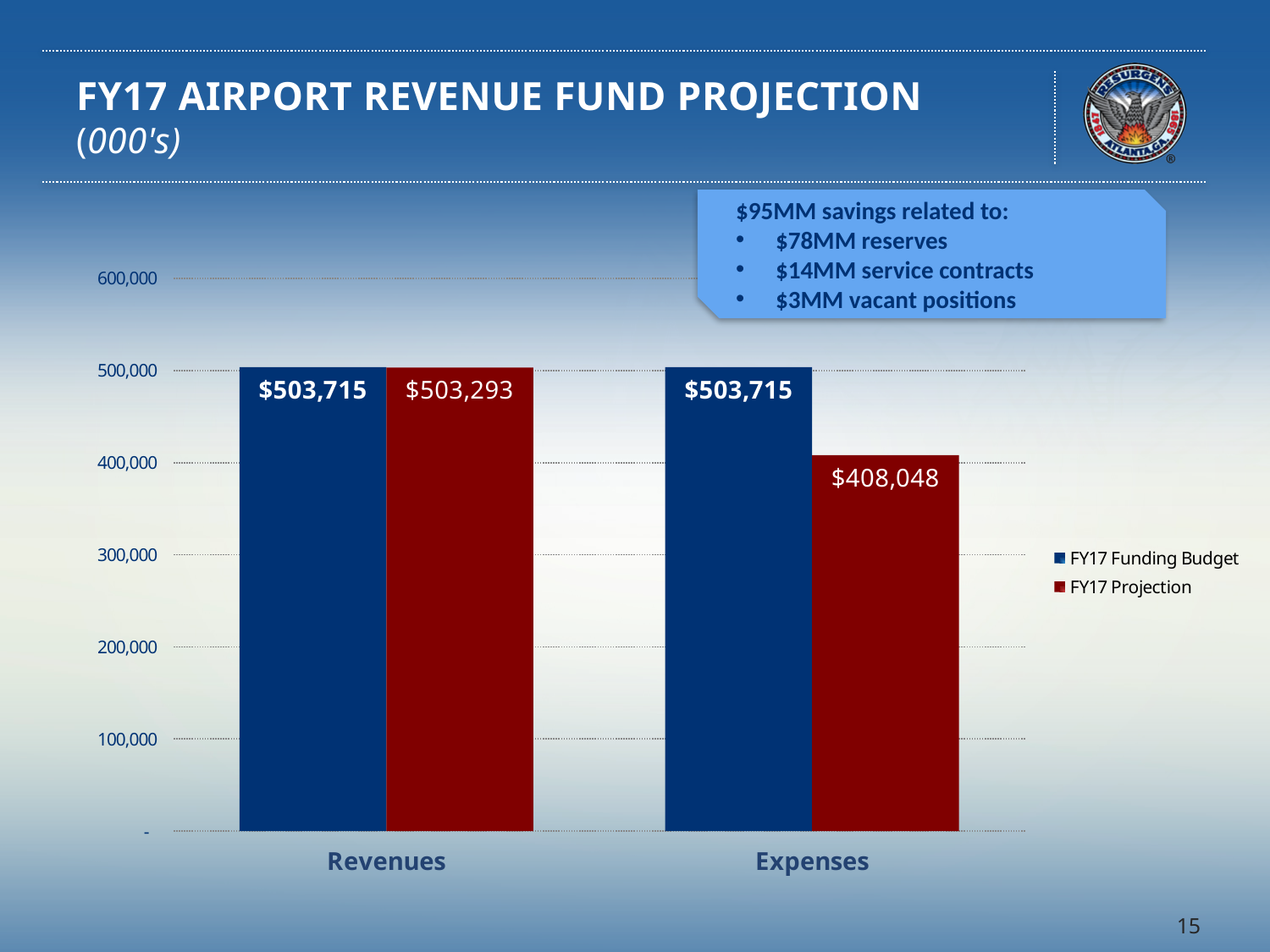
How many series does the legend list? 2 What is the FY17 Projection value for Expenses? $408,048 What is the difference between the FY17 Funding Budget and FY17 Projection for Revenues? $422 Which is larger: the FY17 Projection for Revenues or the FY17 Projection for Expenses? FY17 Projection for Revenues What is the FY17 Funding Budget value for Expenses? $503,715 How many categories are shown on the x axis? 2 What is the difference between the FY17 Funding Budget and FY17 Projection for Expenses? $95,667 What kind of chart is shown on the slide? Bar chart What is the FY17 Funding Budget value for Revenues? $503,715 What is the FY17 Projection value for Revenues? $503,293 Which category has the lowest FY17 Projection value? Expenses Is the FY17 Projection value for Expenses greater or less than 500,000? less